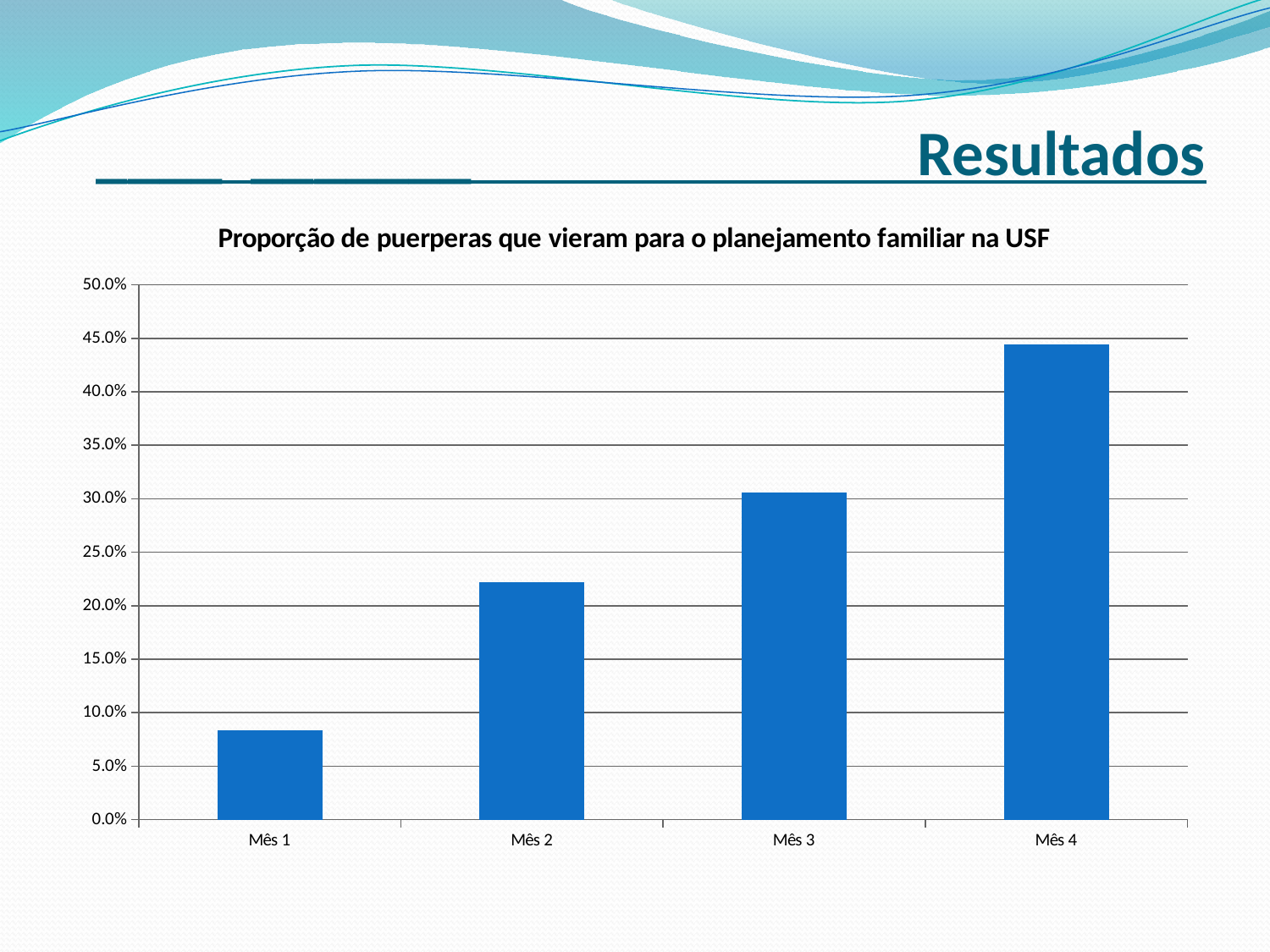
Is the value for Mês 2 greater or less than 20.0%? greater Which month has the lowest proportion? Mês 1 What is the maximum value shown on the y axis? 50.0% What is the title of the chart? Proporção de puerperas que vieram para o planejamento familiar na USF How many categories (months) are shown on the x axis? 4 What type of chart is shown on the slide? bar chart Which is larger, the value for Mês 2 or the value for Mês 3? Mês 3 Is the value for Mês 1 greater or less than 10.0%? less Do the values rise or fall from Mês 1 to Mês 4? rise Which month has the highest proportion? Mês 4